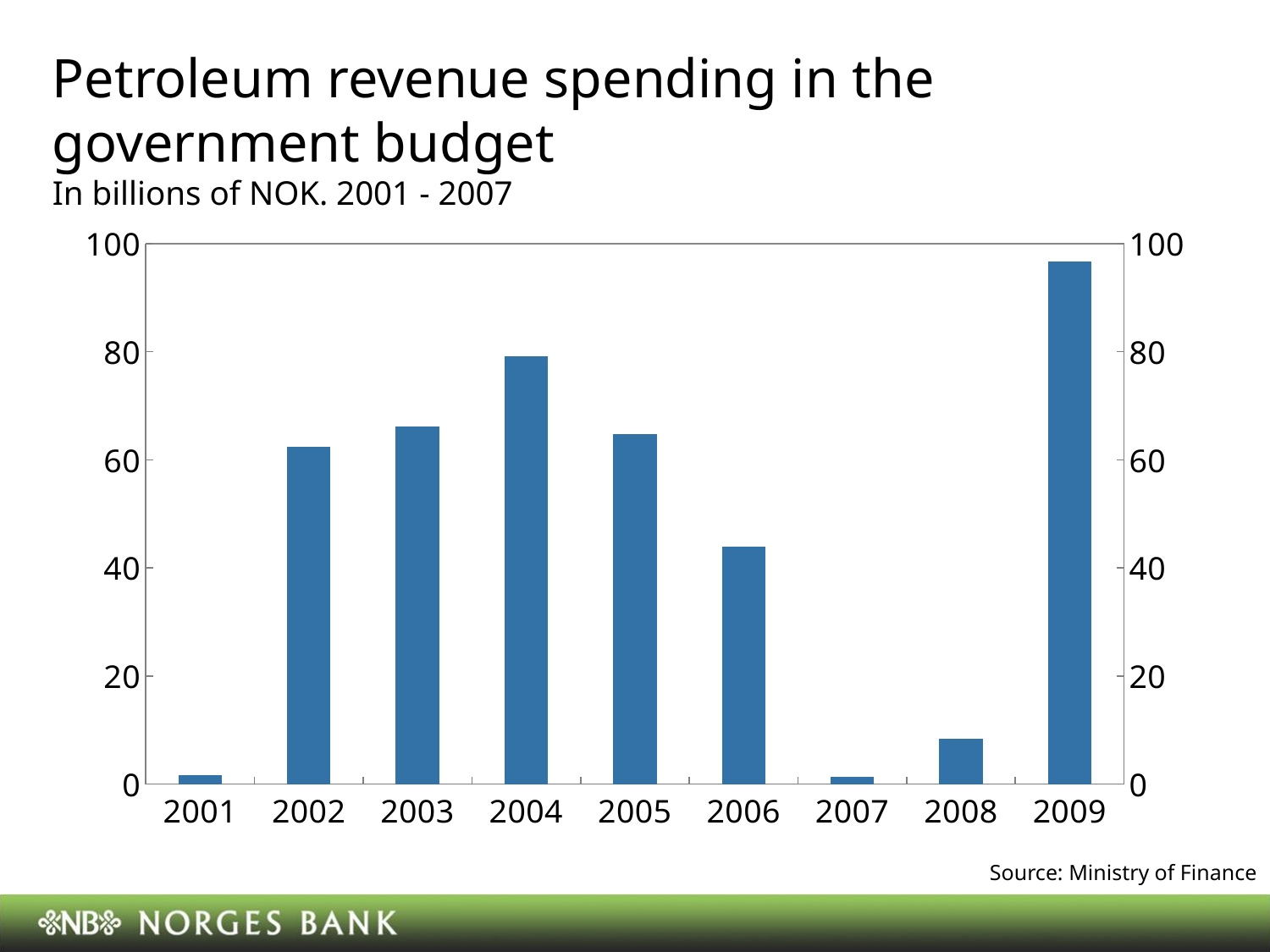
Which year has the larger value, 2009 or 2004? 2009 How many years are shown on the x axis of the chart? 9 Is the value for 2004 greater or less than 60? greater What kind of chart is shown on the slide? bar chart Do the values rise or fall from 2004 to 2007? fall Is the value for 2009 greater or less than 80? greater What is the source cited for the chart? Ministry of Finance Is the value for 2008 greater or less than 20? less Which year has the larger value, 2004 or 2006? 2004 Which year has the highest petroleum revenue spending? 2009